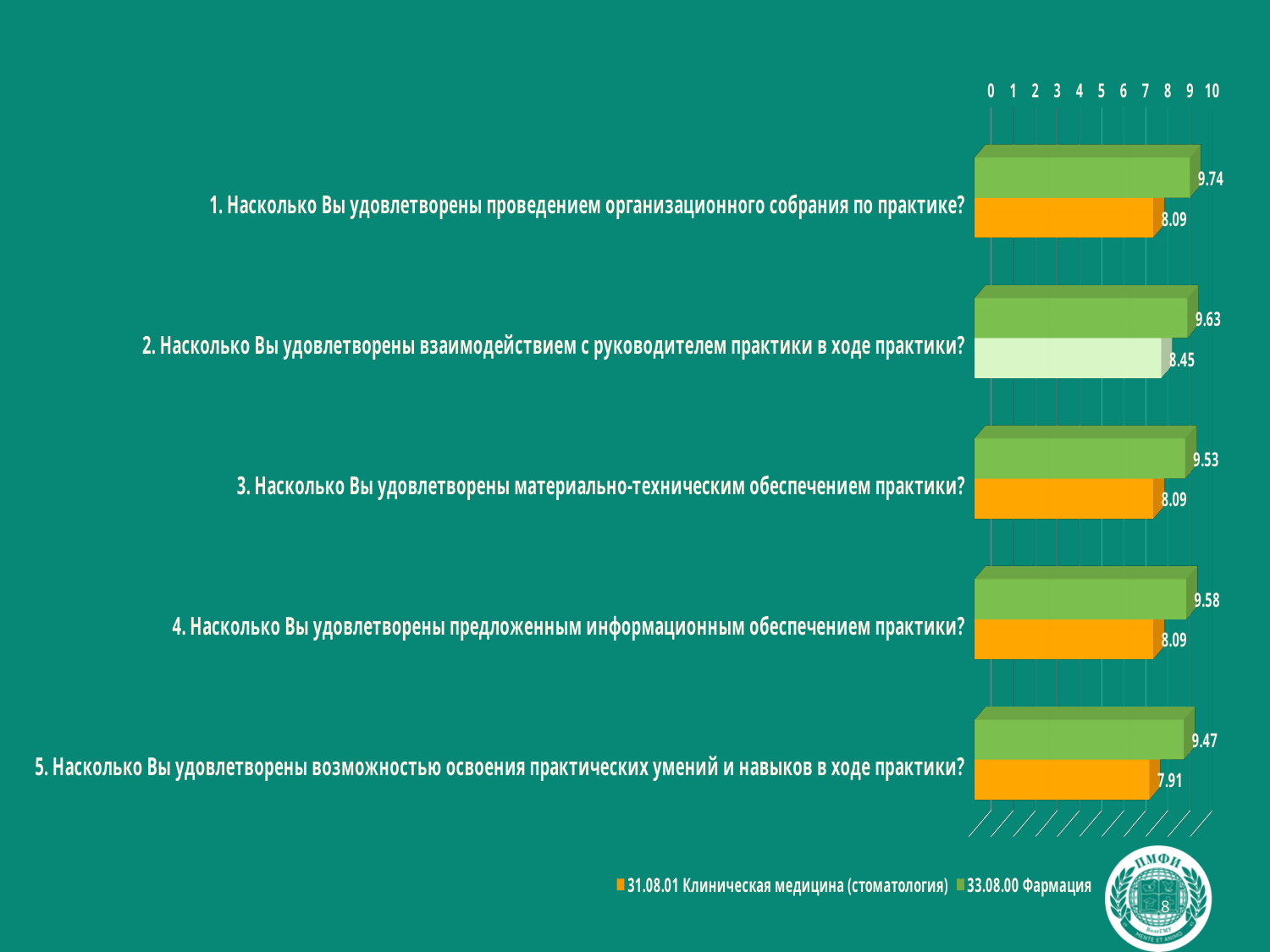
What is the value for 33.08.00 Фармация for question 3 (материально-техническое обеспечение практики)? 9.53 What is the difference between the 33.08.00 Фармация and 31.08.01 Клиническая медицина (стоматология) values for question 1? 1.65 What is the value for 33.08.00 Фармация for question 1 (проведение организационного собрания по практике)? 9.74 How many series does the legend list? 2 Which colour represents the 33.08.00 Фармация series in the legend? Green How many categories (questions) are plotted on the chart? 5 What is the value for 31.08.01 Клиническая медицина (стоматология) for question 5 (возможность освоения практических умений и навыков)? 7.91 For which question is the value for 33.08.00 Фармация the highest? 1. Насколько Вы удовлетворены проведением организационного собрания по практике? What is the value for 31.08.01 Клиническая медицина (стоматология) for question 4 (информационное обеспечение практики)? 8.09 For question 5, which series has the larger value: 33.08.00 Фармация or 31.08.01 Клиническая медицина (стоматология)? 33.08.00 Фармация What kind of chart is shown on the slide? Bar chart For which question is the value for 31.08.01 Клиническая медицина (стоматология) the lowest? 5. Насколько Вы удовлетворены возможностью освоения практических умений и навыков в ходе практики?